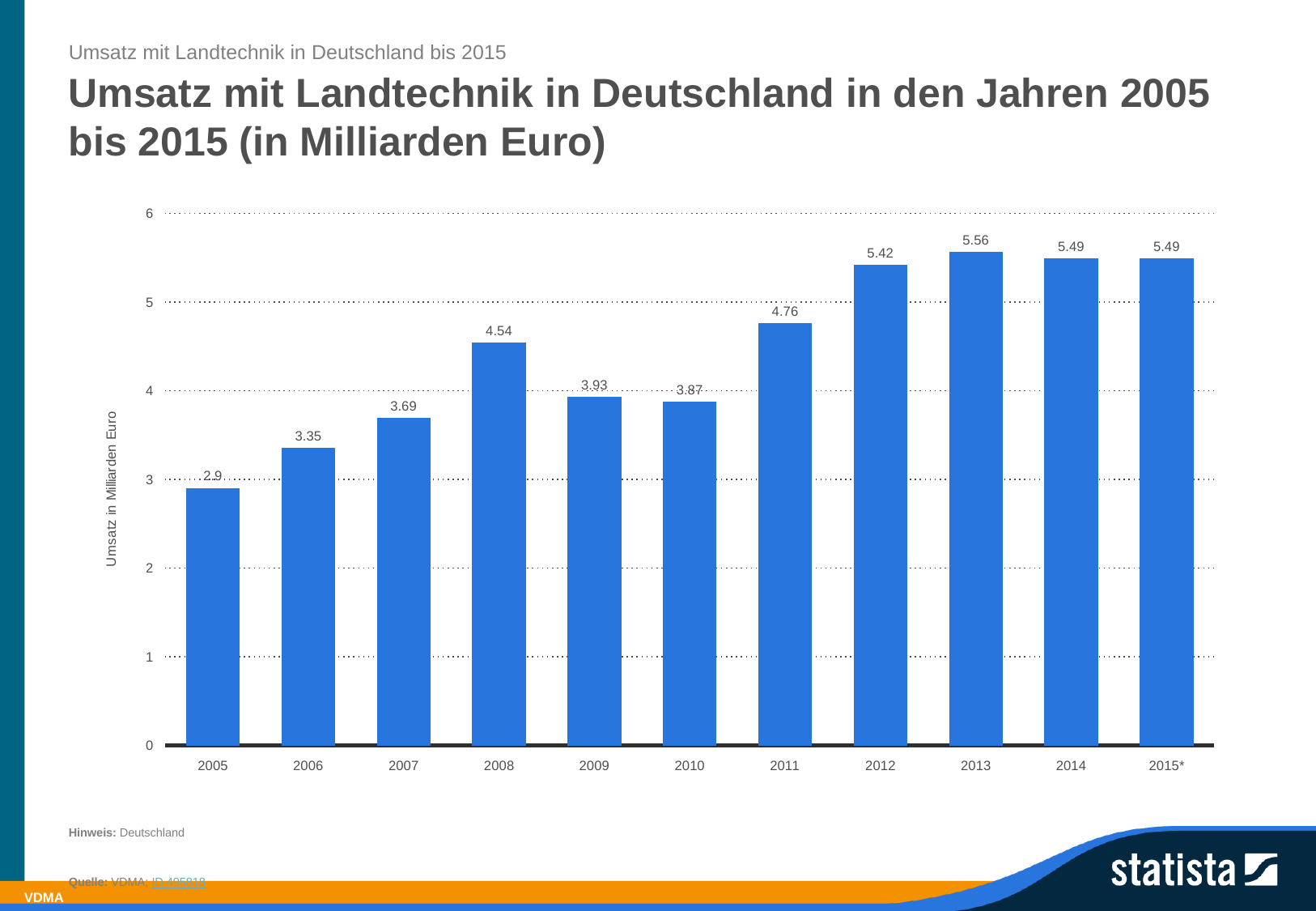
Which year has the highest value? 2013 Which is larger, the value for 2008 or the value for 2009? 2008 What value is shown for 2005? 2.9 How many years are shown on the x axis? 11 What is the difference between the values for 2009 and 2010? 0.06 What is the label of the y axis? Umsatz in Milliarden Euro What value is shown for 2012? 5.42 Which year has the lowest value? 2005 What kind of chart is shown on the slide? bar chart What was the revenue from agricultural machinery in Germany in 2008? 4.54 What is the difference between the values for 2013 and 2005? 2.66 Is the value for 2011 greater or less than 5? less